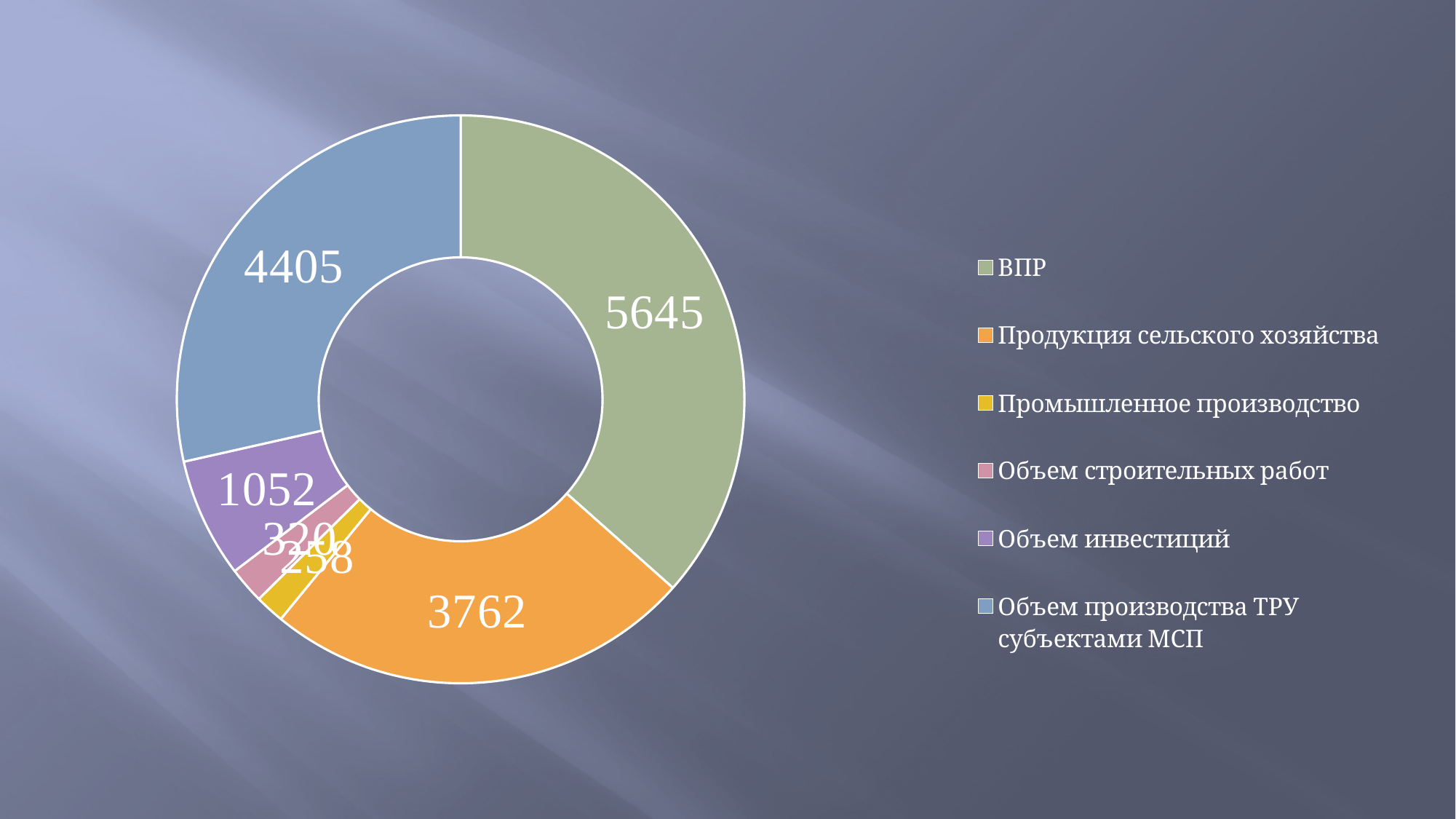
What kind of chart is shown on the slide? Doughnut chart What is the difference between the values for Объем производства ТРУ субъектами МСП and Продукция сельского хозяйства? 643 Which category has the smallest slice? Промышленное производство Which is larger, Объем инвестиций or Объем строительных работ? Объем инвестиций What is the value for Объем строительных работ? 320 What is the value for Продукция сельского хозяйства? 3762 What is the difference between the values for ВПР and Продукция сельского хозяйства? 1883 What is the value for Объем производства ТРУ субъектами МСП? 4405 How many categories does the chart show? 6 What is the value for Объем инвестиций? 1052 Which category has the largest slice? ВПР What is the value for ВПР? 5645